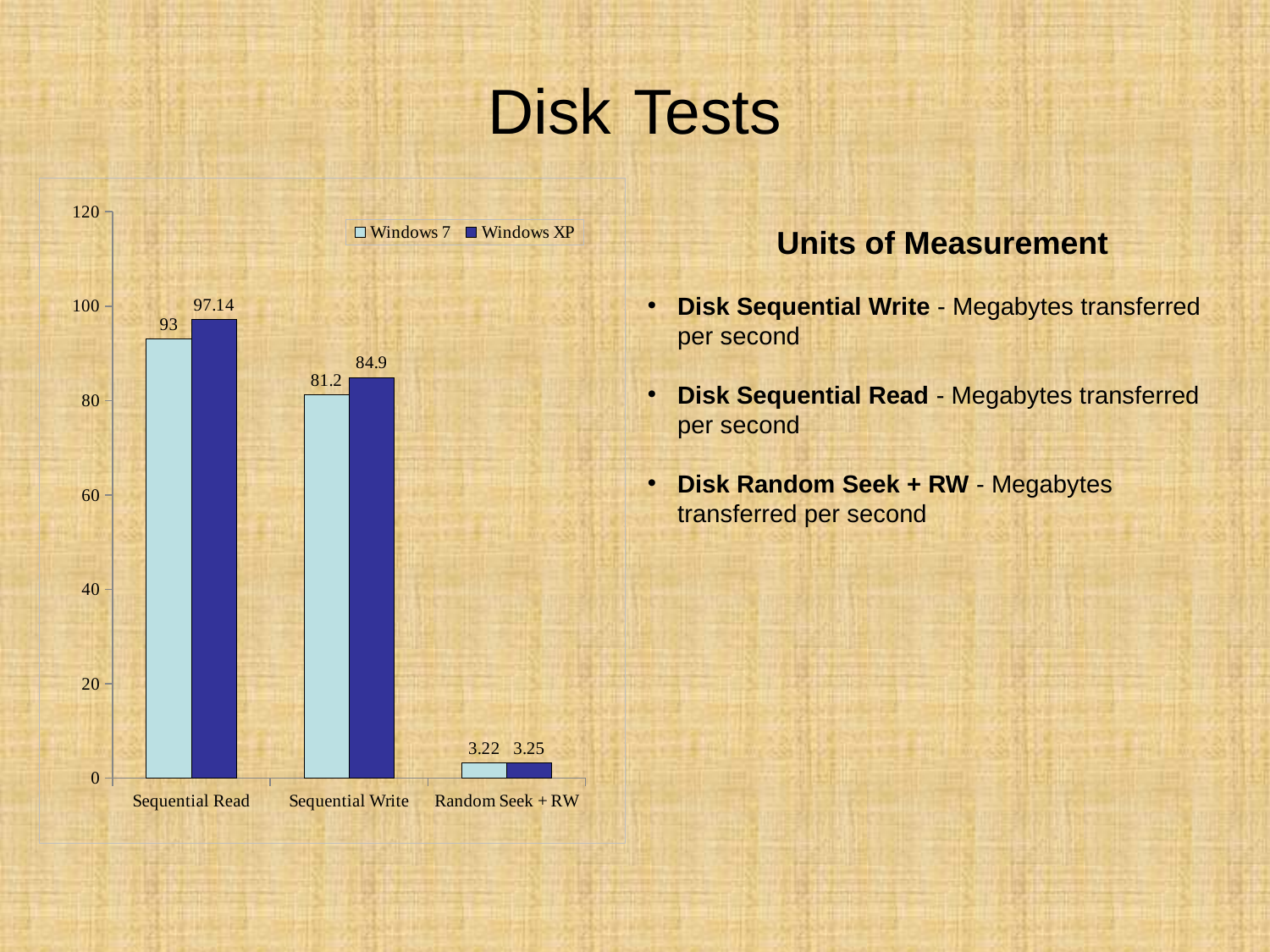
What is the difference between the Windows XP and Windows 7 values for Sequential Read? 4.14 What is the Windows XP value for Random Seek + RW? 3.25 What is the Windows 7 value for Sequential Read? 93 How many series does the legend list? 2 Which category has the highest Windows XP value? Sequential Read Is the Windows 7 value for Sequential Write greater or less than 100? less How many categories are shown on the x axis? 3 For Sequential Write, which is larger: the Windows 7 value or the Windows XP value? Windows XP Which category has the lowest Windows 7 value? Random Seek + RW What is the difference between the Windows XP and Windows 7 values for Sequential Write? 3.7 What is the Windows XP value for Sequential Write? 84.9 What kind of chart is shown on the slide? bar chart